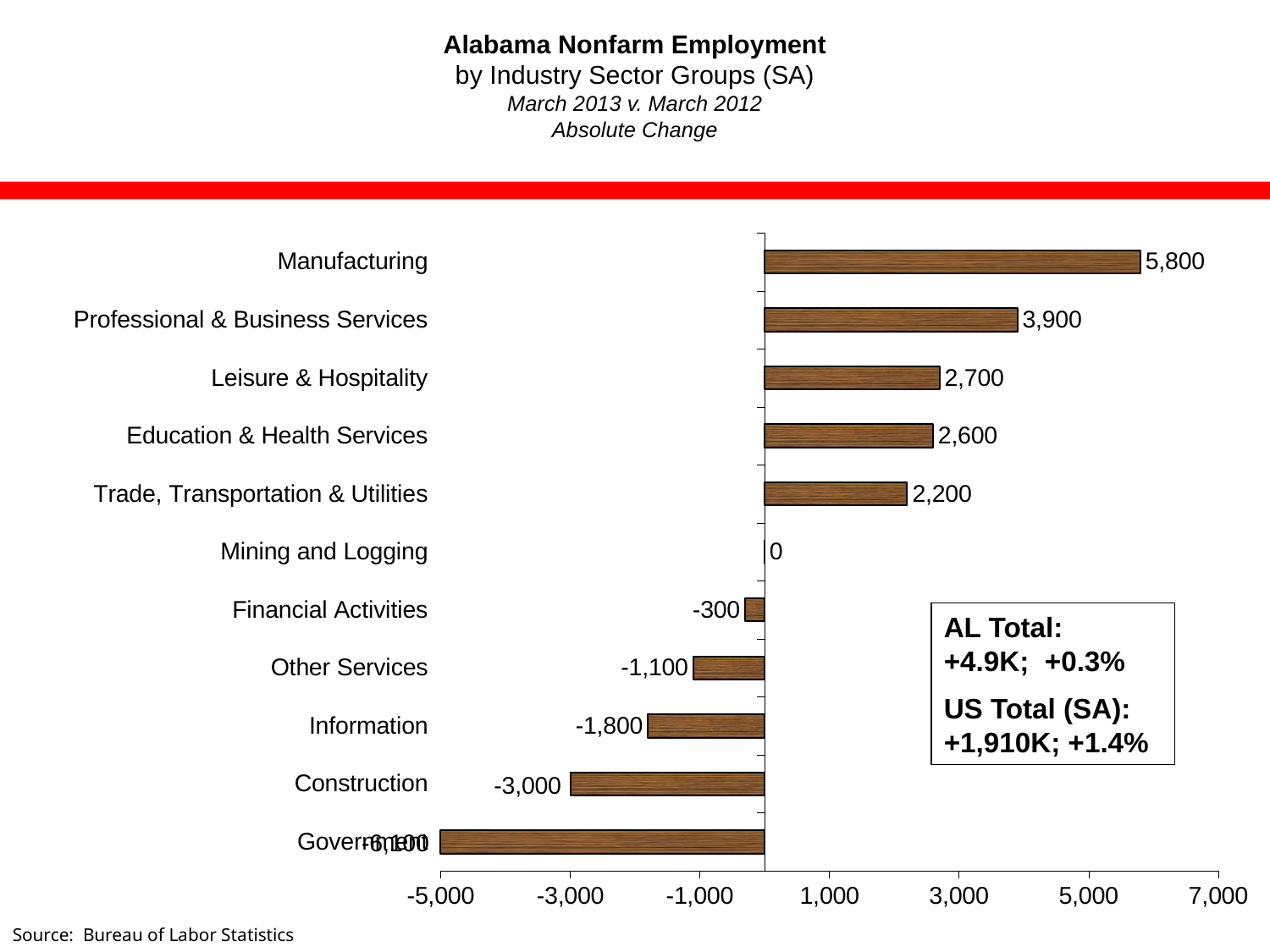
Which industry sector has the lowest value? Government What is the value for Construction? -3,000 What is the value for Mining and Logging? 0 What is the value for Manufacturing? 5,800 Which industry sector has the highest value? Manufacturing Which is larger, the value for Leisure & Hospitality or the value for Education & Health Services? Leisure & Hospitality What is the value for Professional & Business Services? 3,900 How many industry sector categories are shown in the chart? 11 Is the value for Trade, Transportation & Utilities greater or less than 3,000? less What is the difference between the values for Manufacturing and Professional & Business Services? 1,900 According to the text box on the chart, what is the AL Total? +4.9K; +0.3% What kind of chart is shown on the slide? bar chart